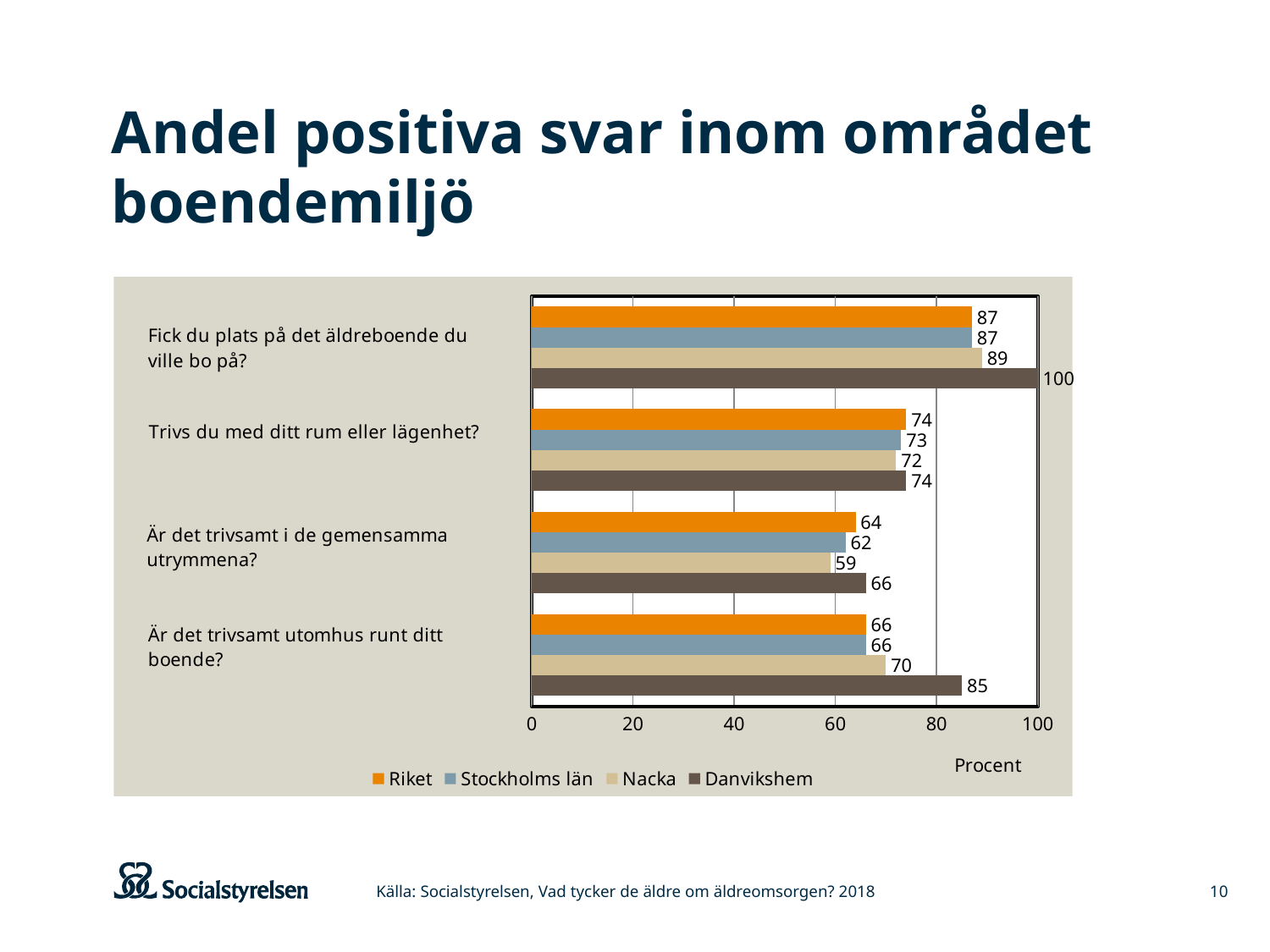
What kind of chart is shown on the slide? Bar chart What is the label on the horizontal axis of the chart? Procent How many series does the legend list? 4 What value does Danvikshem have for "Fick du plats på det äldreboende du ville bo på?"? 100 Which series has the lowest value for "Är det trivsamt i de gemensamma utrymmena?"? Nacka What value does Riket have for "Är det trivsamt utomhus runt ditt boende?"? 66 How many questions (categories) are shown on the chart? 4 For "Fick du plats på det äldreboende du ville bo på?", which is larger: Nacka or Riket? Nacka What value does Nacka have for "Är det trivsamt i de gemensamma utrymmena?"? 59 What is the difference between Danvikshem and Nacka for "Är det trivsamt utomhus runt ditt boende?"? 15 What value does Stockholms län have for "Trivs du med ditt rum eller lägenhet?"? 73 Which series has the highest value for "Är det trivsamt utomhus runt ditt boende?"? Danvikshem